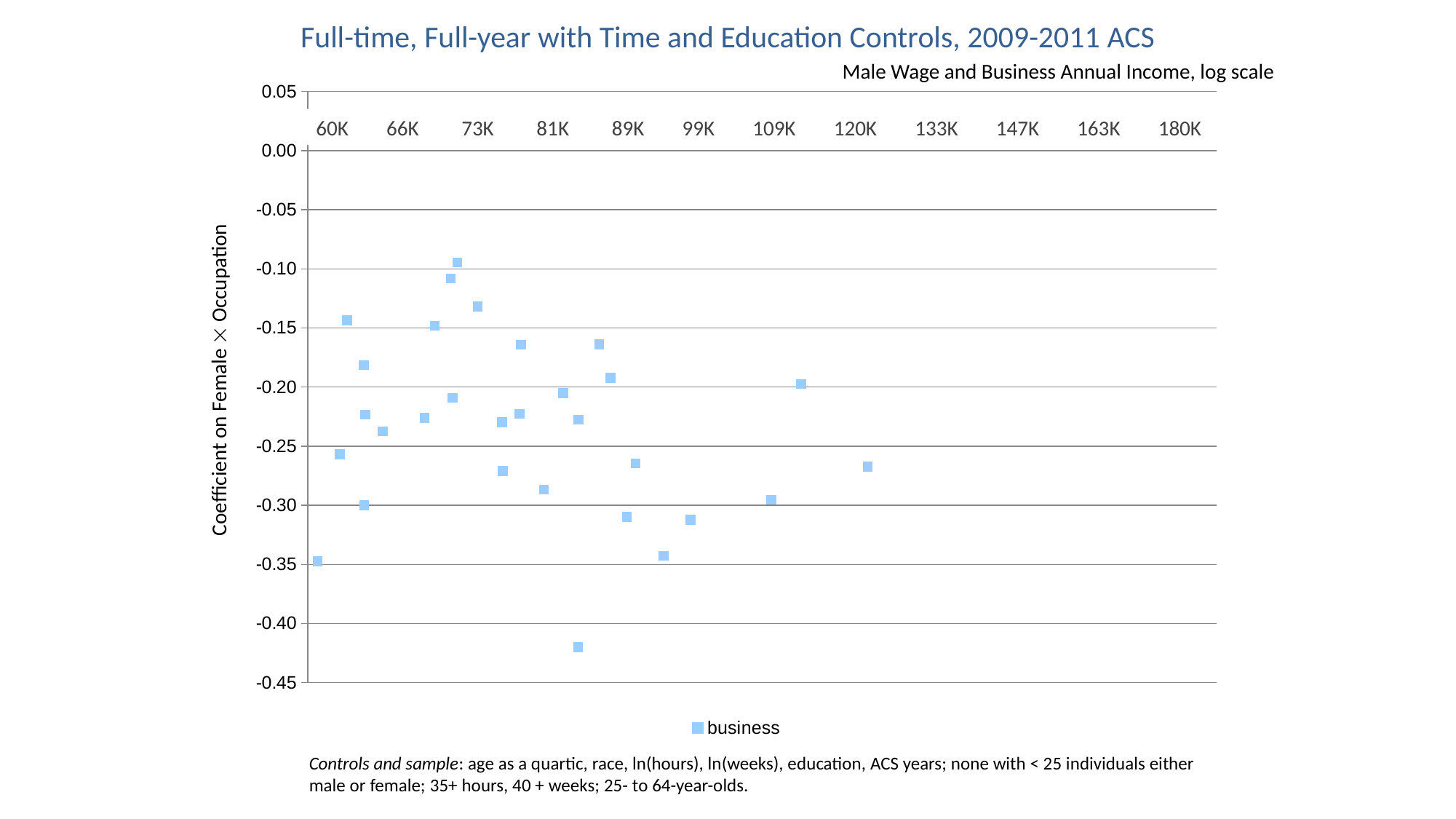
Is the highest point on the chart greater or less than -0.15? greater Is the rightmost point on the chart (near 120K) greater or less than -0.30? greater Is the lowest point on the chart greater or less than -0.40? less What kind of chart is shown on the slide? scatter chart How many series does the legend list? 1 What is the title of the chart? Full-time, Full-year with Time and Education Controls, 2009-2011 ACS What is the name of the series shown in the legend? business